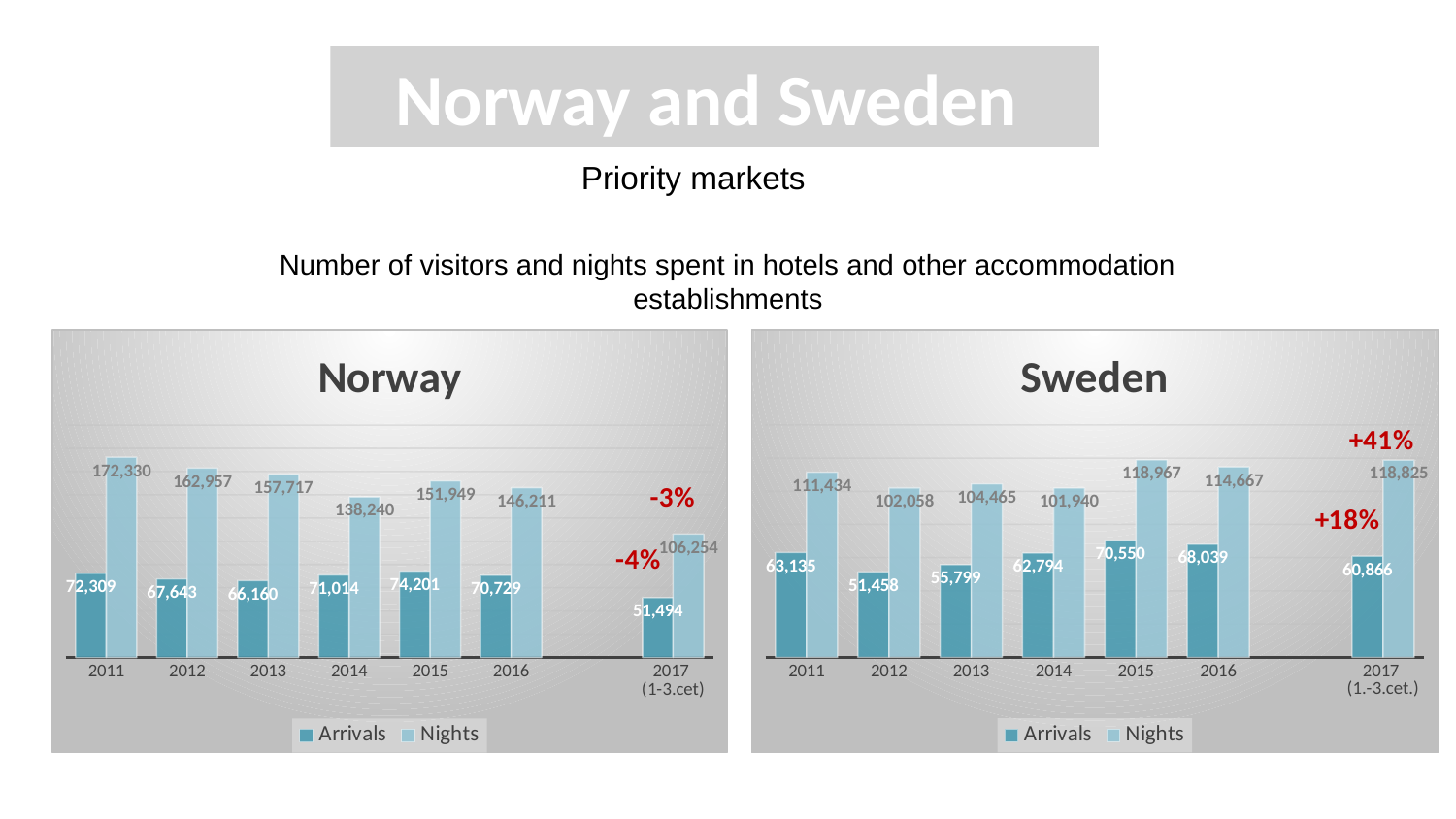
In the Norway chart, what is the value for Arrivals in 2017 (1-3.cet)? 51,494 In the Norway chart, what is the difference between Nights and Arrivals in 2011? 100,021 What type of chart is the Sweden chart? Bar chart How many year categories are shown on the x axis of the Norway chart? 7 In the Norway chart, what is the value for Nights in 2011? 172,330 In the Norway chart, which is larger: Arrivals in 2015 or Arrivals in 2016? Arrivals in 2015 In the Sweden chart, what is the value for Arrivals in 2015? 70,550 In the Sweden chart, what is the difference between Arrivals in 2015 and Arrivals in 2016? 2,511 In the Sweden chart, which year has the lowest value for Arrivals? 2012 How many series does the legend of the Sweden chart list? 2 In the Sweden chart, what is the value for Nights in 2014? 101,940 In the Norway chart, which year has the highest value for Nights? 2011